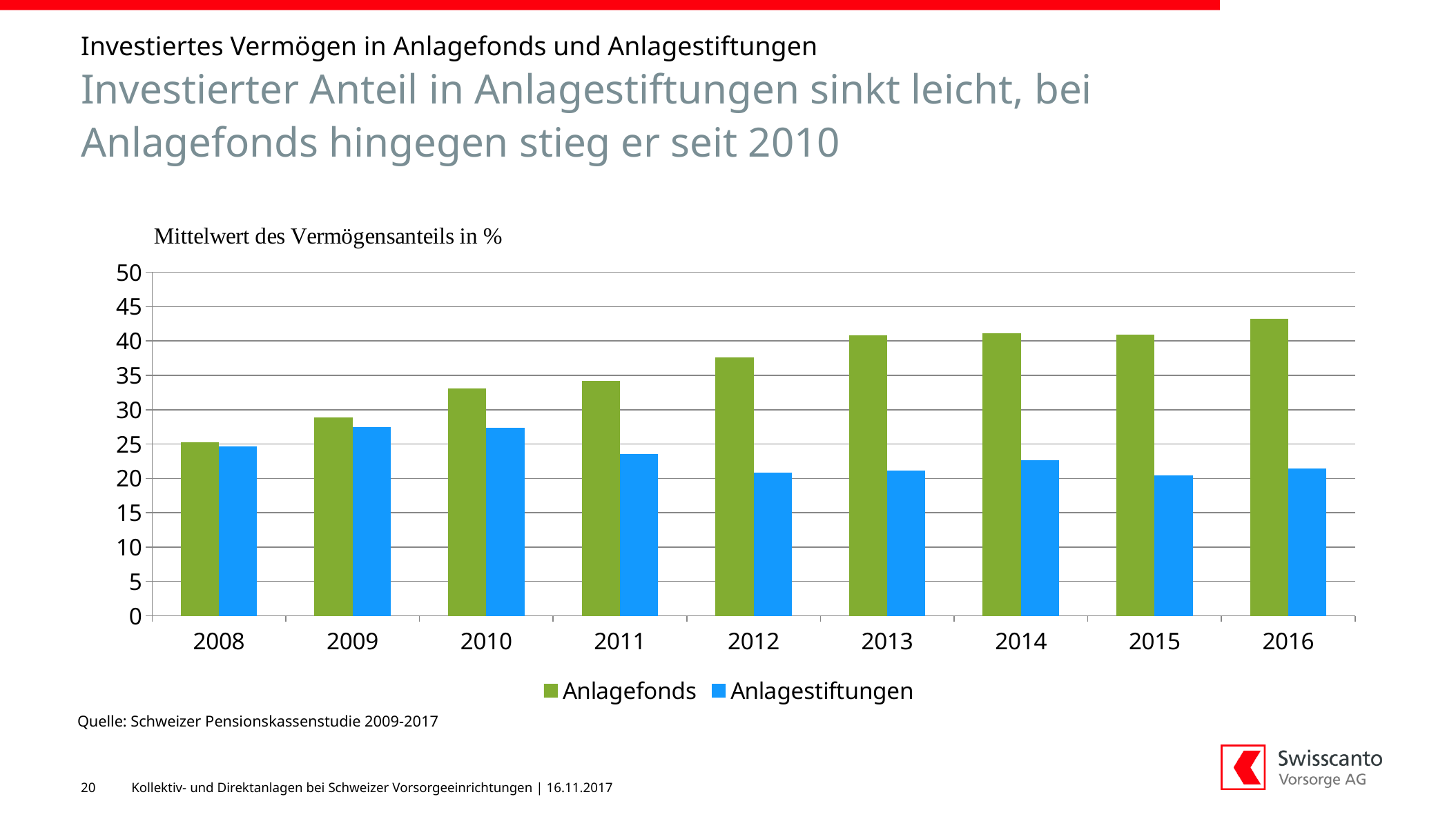
In which year is the Anlagefonds value highest? 2016 What kind of chart is shown on the slide? bar chart Is the Anlagefonds value for 2009 greater or less than 30? less How many years are shown on the x axis? 9 Is the Anlagestiftungen value for 2009 greater or less than 25? greater Does the Anlagefonds value generally rise or fall from 2008 to 2016? rise Is the Anlagestiftungen value for 2011 greater or less than 25? less In 2016, which series has the larger value, Anlagefonds or Anlagestiftungen? Anlagefonds How many series does the legend list? 2 In which year is the Anlagefonds value lowest? 2008 Which colour represents Anlagestiftungen in the chart? blue